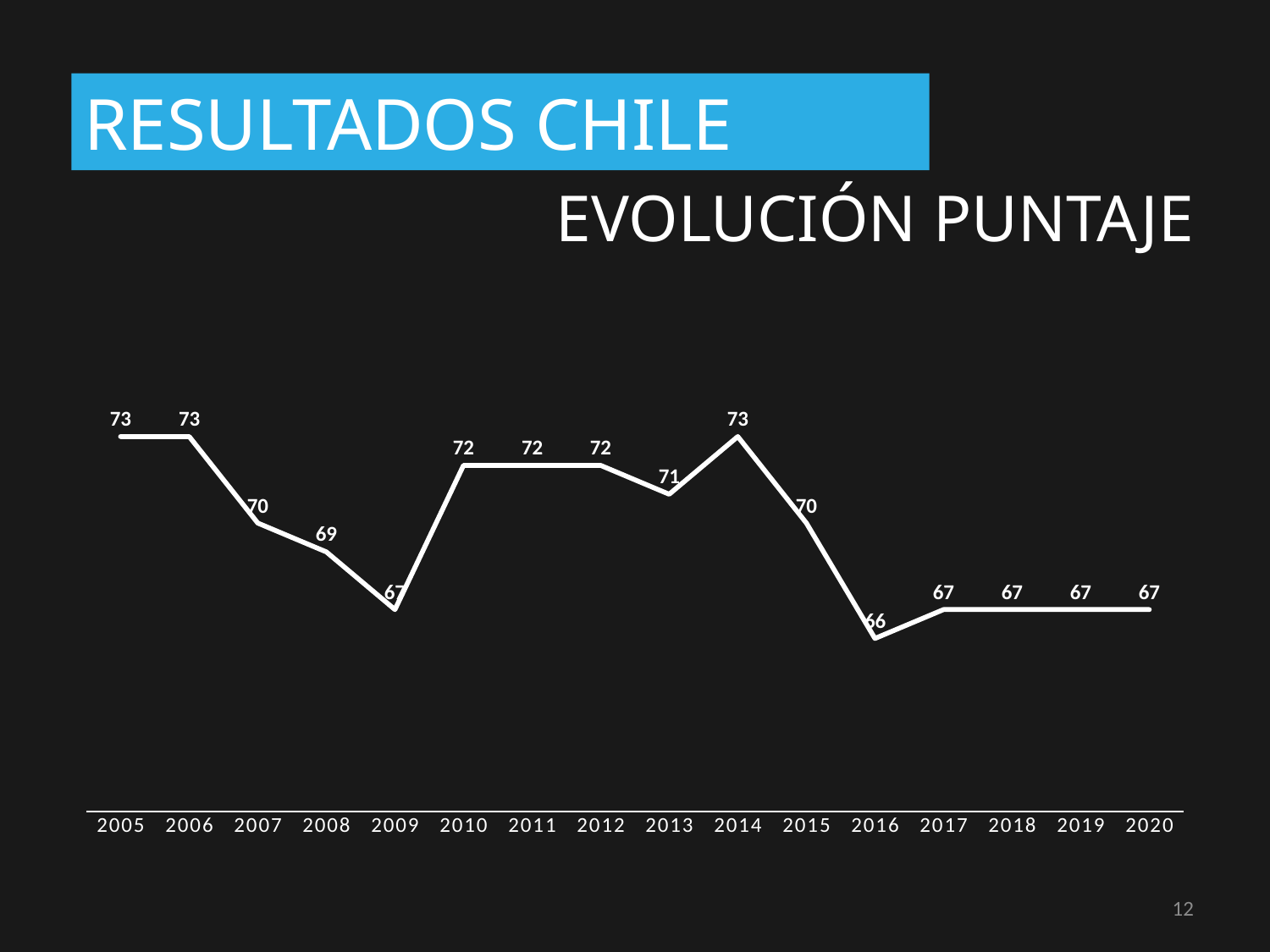
What kind of chart is shown? line chart How many years are plotted on the x axis? 16 What is the difference between the values for 2014 and 2016? 7 Which year has the lowest value? 2016 Do the values rise or fall from 2014 to 2016? fall What is the value for 2013? 71 What is the difference between the values for 2006 and 2007? 3 What is the title of the chart? EVOLUCIÓN PUNTAJE What is the value for 2016? 66 What is the value for 2005? 73 What is the value for 2009? 67 Which is larger, the value for 2010 or the value for 2015? 2010